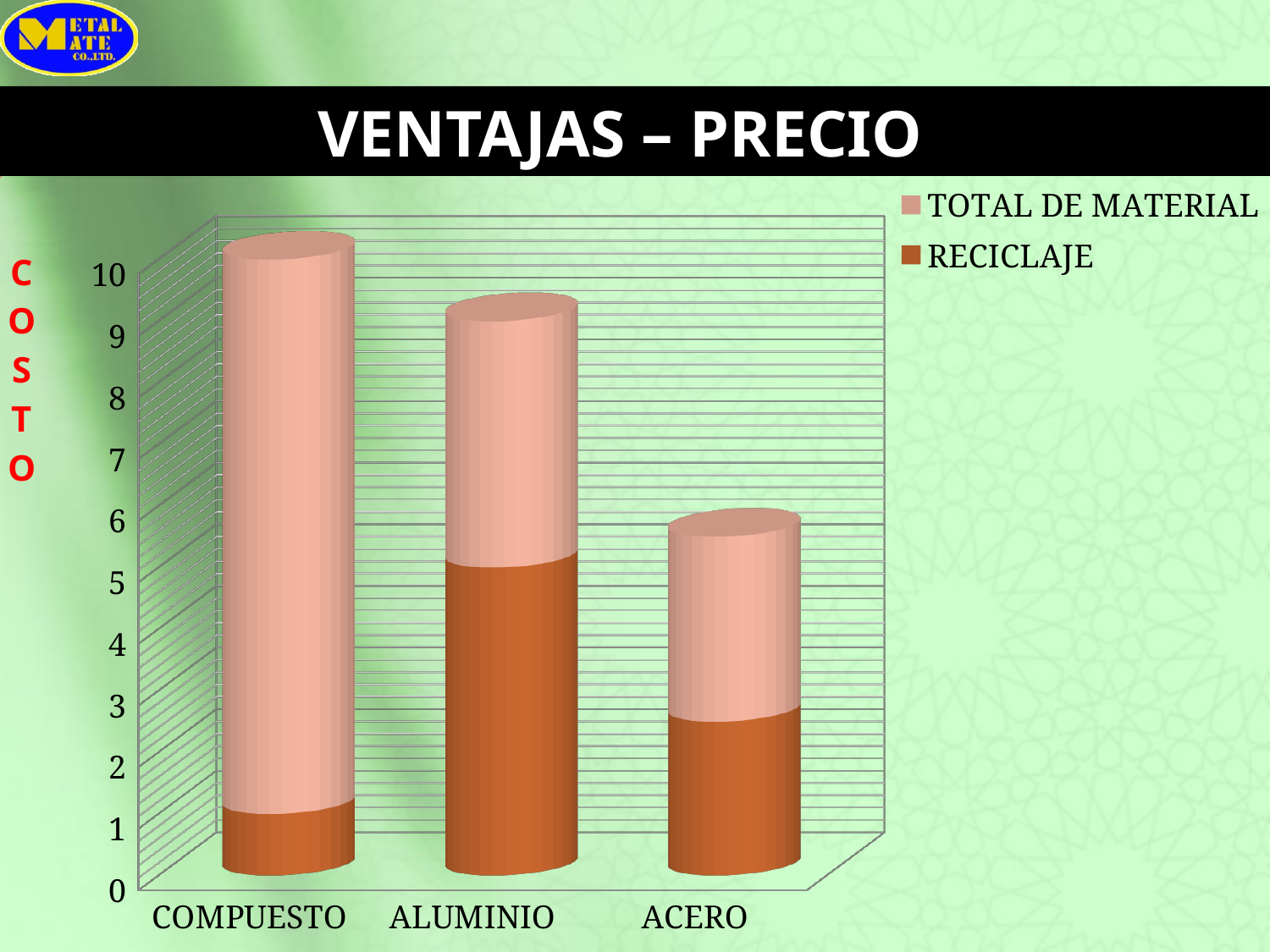
Is the total bar height for COMPUESTO greater or less than 8? greater How many series does the chart legend list? 2 Which category has the tallest bar overall? COMPUESTO Is the total bar height for ACERO greater or less than 8? less Which category has the largest RECICLAJE segment? ALUMINIO What kind of chart is shown on the slide? bar chart Which category has the shortest bar overall? ACERO Do the overall bar heights rise or fall from left to right across the x axis? fall How many categories are shown on the x axis of the chart? 3 What label is shown on the vertical axis of the chart? COSTO Which category has the smallest RECICLAJE segment? COMPUESTO Is the RECICLAJE value for ALUMINIO greater or less than 3? greater